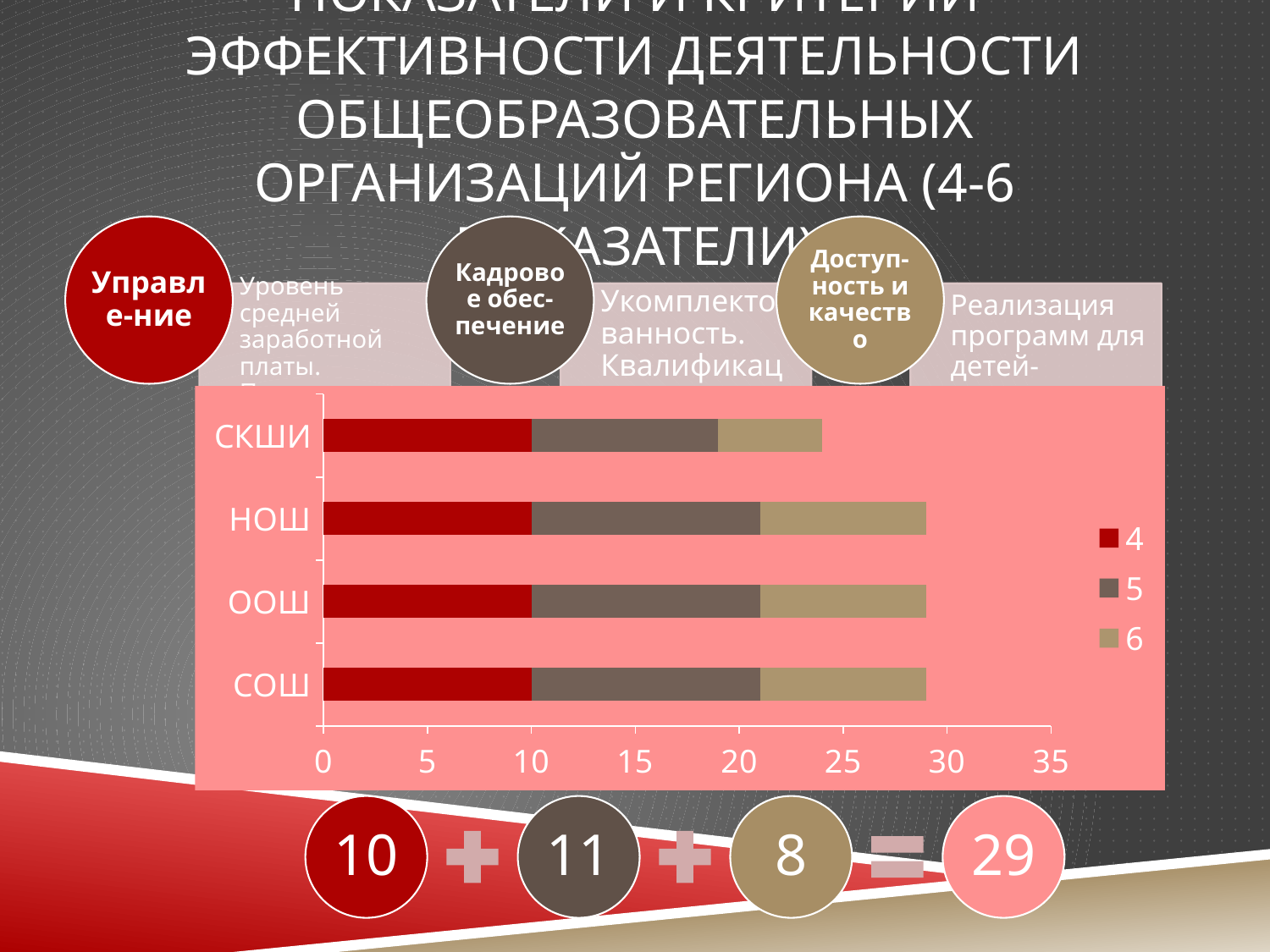
What is the highest value shown on the horizontal axis? 35 Is the total bar length for СОШ greater or less than 30? less How many categories are plotted on the chart's vertical axis? 4 How many series does the chart legend list? 3 Is the red segment (series 4) for ООШ greater or less than 5? greater Is the total bar length for СКШИ greater or less than 25? less What are the entries in the chart legend? 4, 5, 6 What kind of chart is shown on the slide? bar chart Which category is listed at the top of the chart? СКШИ Which category has the shortest total bar? СКШИ Which has the longer total bar, НОШ or СКШИ? НОШ